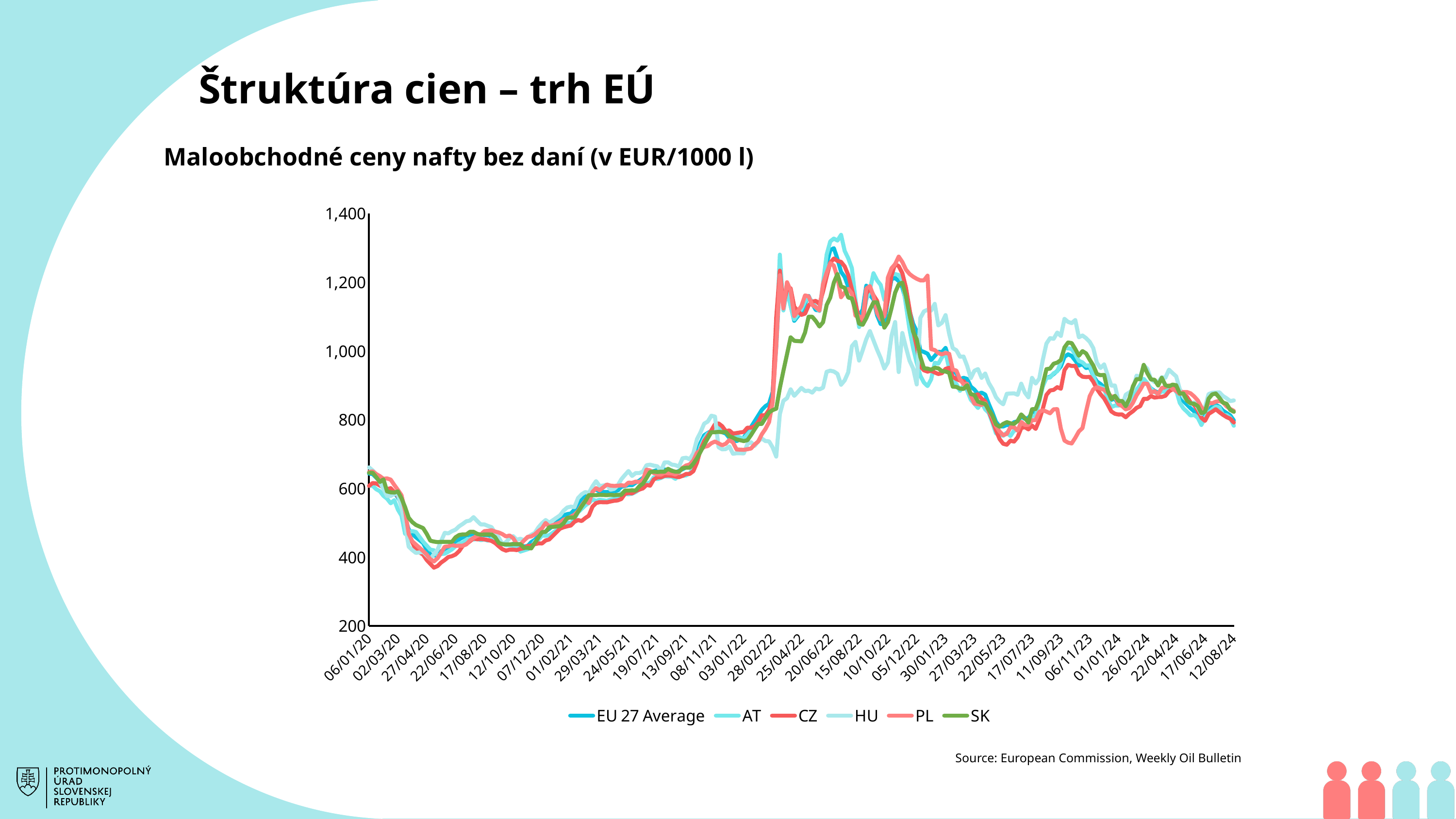
Do the values for EU 27 Average rise or fall between 27/04/20 and 28/02/22? rise How many date labels are shown on the x axis? 31 What kind of chart is shown on the slide? line chart Is the value for PL at 25/04/22 greater or less than 1,000? greater Is the value for EU 27 Average at 06/01/20 greater or less than 800? less Is the value for HU at 12/08/24 greater or less than 1,000? less Do the values for SK rise or fall between 20/06/22 and 22/05/23? fall How many series does the legend list? 6 What source is cited for the chart? European Commission, Weekly Oil Bulletin What is the title of the chart? Maloobchodné ceny nafty bez daní (v EUR/1000 l)